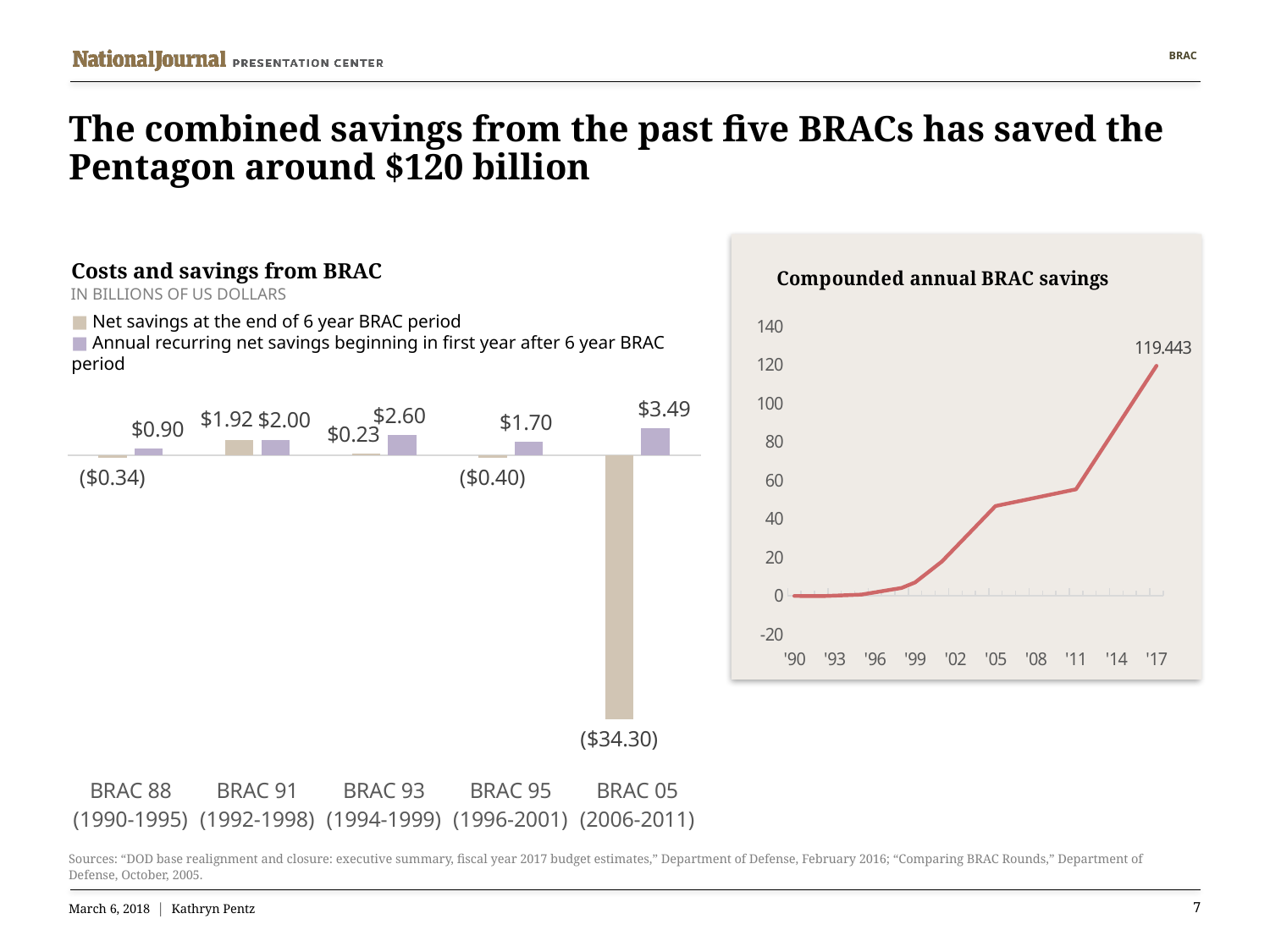
How many BRAC rounds are shown in the 'Costs and savings from BRAC' chart? 5 In the 'Costs and savings from BRAC' chart, what is the net savings at the end of the 6 year BRAC period for BRAC 05 (2006-2011)? ($34.30) In the 'Costs and savings from BRAC' chart, which is larger: the annual recurring net savings for BRAC 88 or for BRAC 95? BRAC 95 What type of chart is 'Compounded annual BRAC savings'? Line chart In the 'Compounded annual BRAC savings' chart, what is the value labelled at the end of the line in '17? 119.443 In the 'Costs and savings from BRAC' chart, what is the difference between the annual recurring net savings of BRAC 93 and BRAC 95? $0.90 In the 'Costs and savings from BRAC' chart, which BRAC round has the lowest net savings at the end of the 6 year BRAC period? BRAC 05 (2006-2011) In the 'Costs and savings from BRAC' chart, what is the annual recurring net savings for BRAC 93 (1994-1999)? $2.60 In the 'Costs and savings from BRAC' chart, what is the net savings at the end of the 6 year BRAC period for BRAC 91 (1992-1998)? $1.92 How many series does the legend of the 'Costs and savings from BRAC' chart list? 2 In the 'Costs and savings from BRAC' chart, which BRAC round has the highest annual recurring net savings? BRAC 05 (2006-2011) In the 'Compounded annual BRAC savings' chart, is the value for '05 greater or less than 20? greater